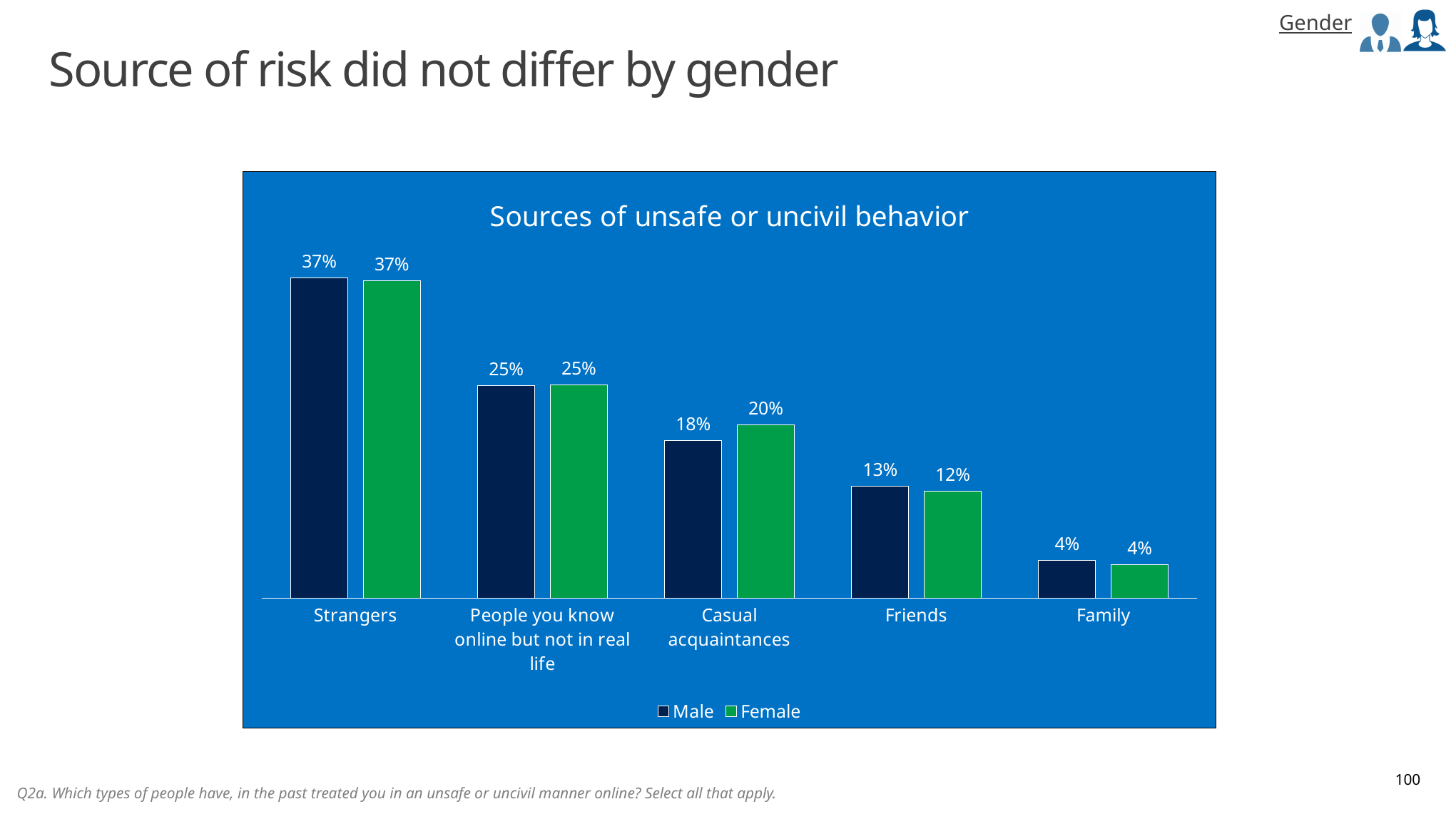
What is the difference between the Female and Male values for Casual acquaintances? 2% Which category has the lowest Male value? Family What type of chart is shown? Bar chart What is the Male value for Strangers? 37% What is the Female value for Casual acquaintances? 20% What is the Male value for Friends? 13% For Friends, which is larger, the Male value or the Female value? Male What is the Female value for Family? 4% How many categories are shown on the x axis? 5 Which category has the highest Female value? Strangers How many series does the legend list? 2 What is the difference between the Male values for Strangers and Friends? 24%